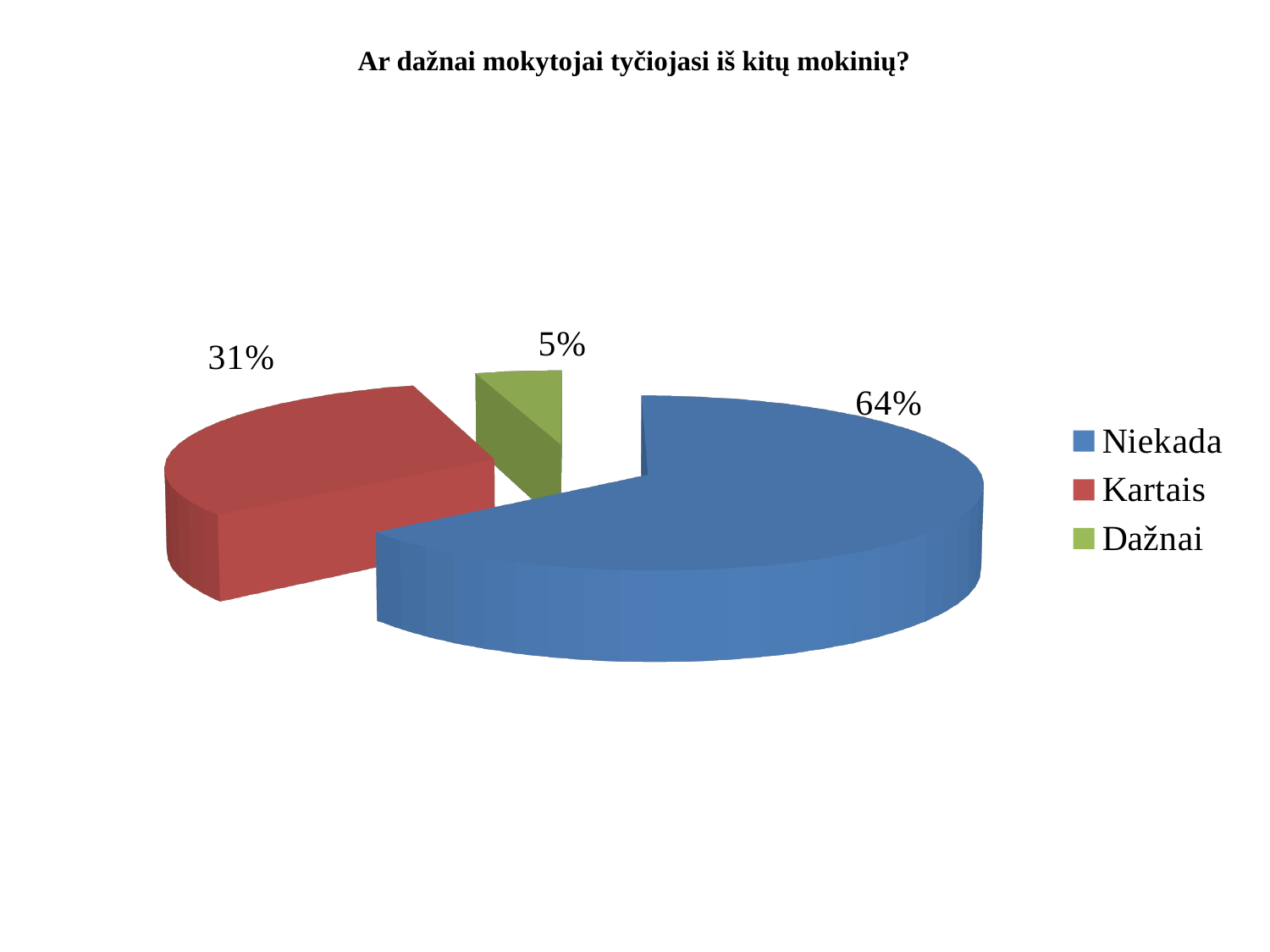
Which is larger, the share for Kartais or the share for Dažnai? Kartais What is the title of the chart? Ar dažnai mokytojai tyčiojasi iš kitų mokinių? Which category has the smallest slice of the pie? Dažnai Which category has the largest slice of the pie? Niekada What kind of chart is shown on the slide? pie chart What is the difference in percentage points between Kartais and Dažnai? 26 What is the difference in percentage points between Niekada and Kartais? 33 What colour is the slice for Kartais? red What share of the pie does Kartais have? 31% How many categories does the pie chart have? 3 What share of the pie does Niekada have? 64% What share of the pie does Dažnai have? 5%